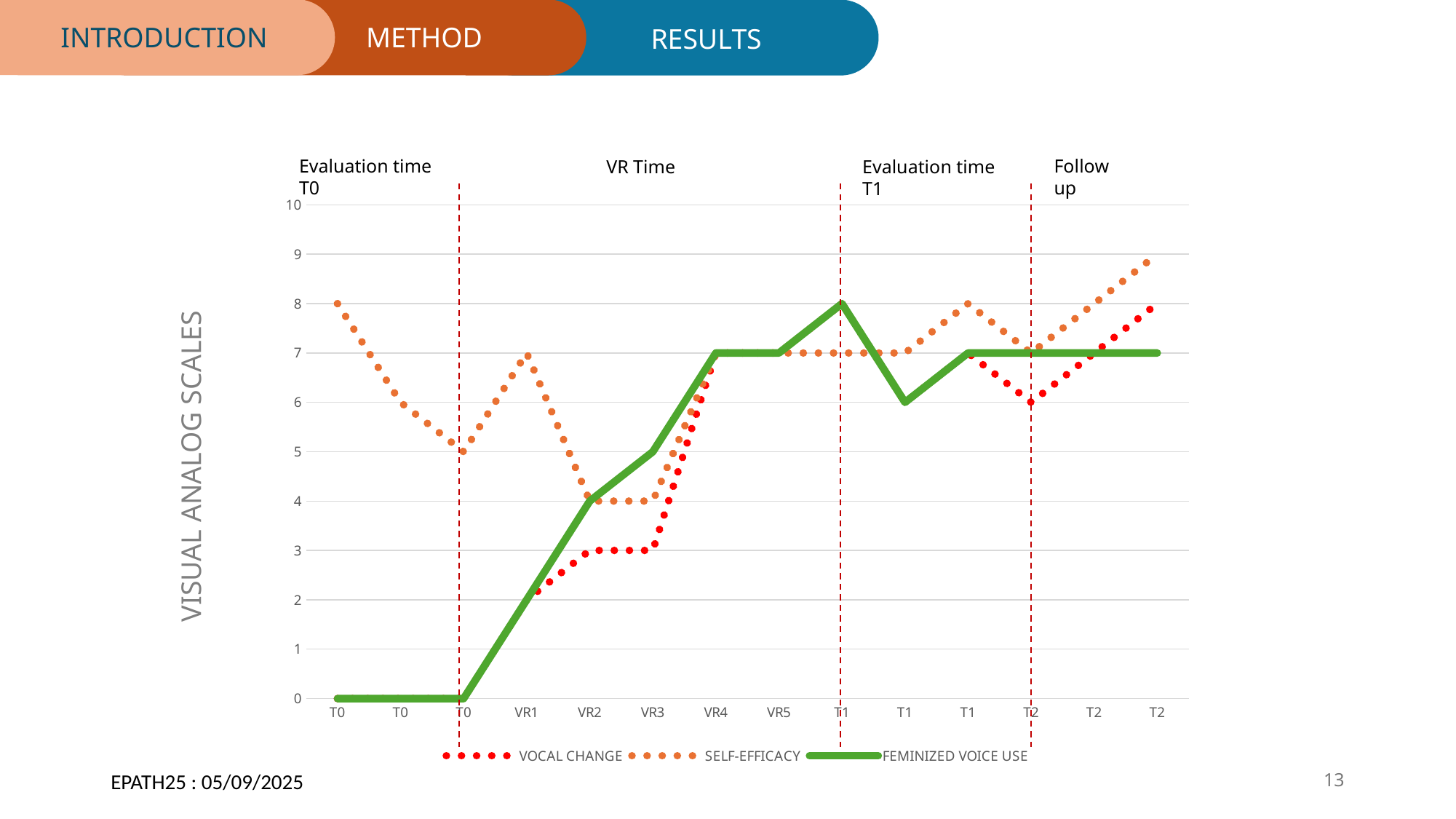
What is the title of the y axis? VISUAL ANALOG SCALES What kind of chart is shown on the slide? line chart Is the value of SELF-EFFICACY at the last T2 point greater or less than 8? greater What is the value of SELF-EFFICACY at the first T0 point? 8 At VR1, which series has the higher value, SELF-EFFICACY or FEMINIZED VOICE USE? SELF-EFFICACY What is the value of FEMINIZED VOICE USE at the first T0 point? 0 What is the value of FEMINIZED VOICE USE at the first T1 point? 8 What is the highest value reached by FEMINIZED VOICE USE? 8 How many series does the legend list? 3 How many points are labelled along the x axis? 14 Does FEMINIZED VOICE USE rise or fall from the third T0 point to VR4? rise What is the value of VOCAL CHANGE at VR2? 3